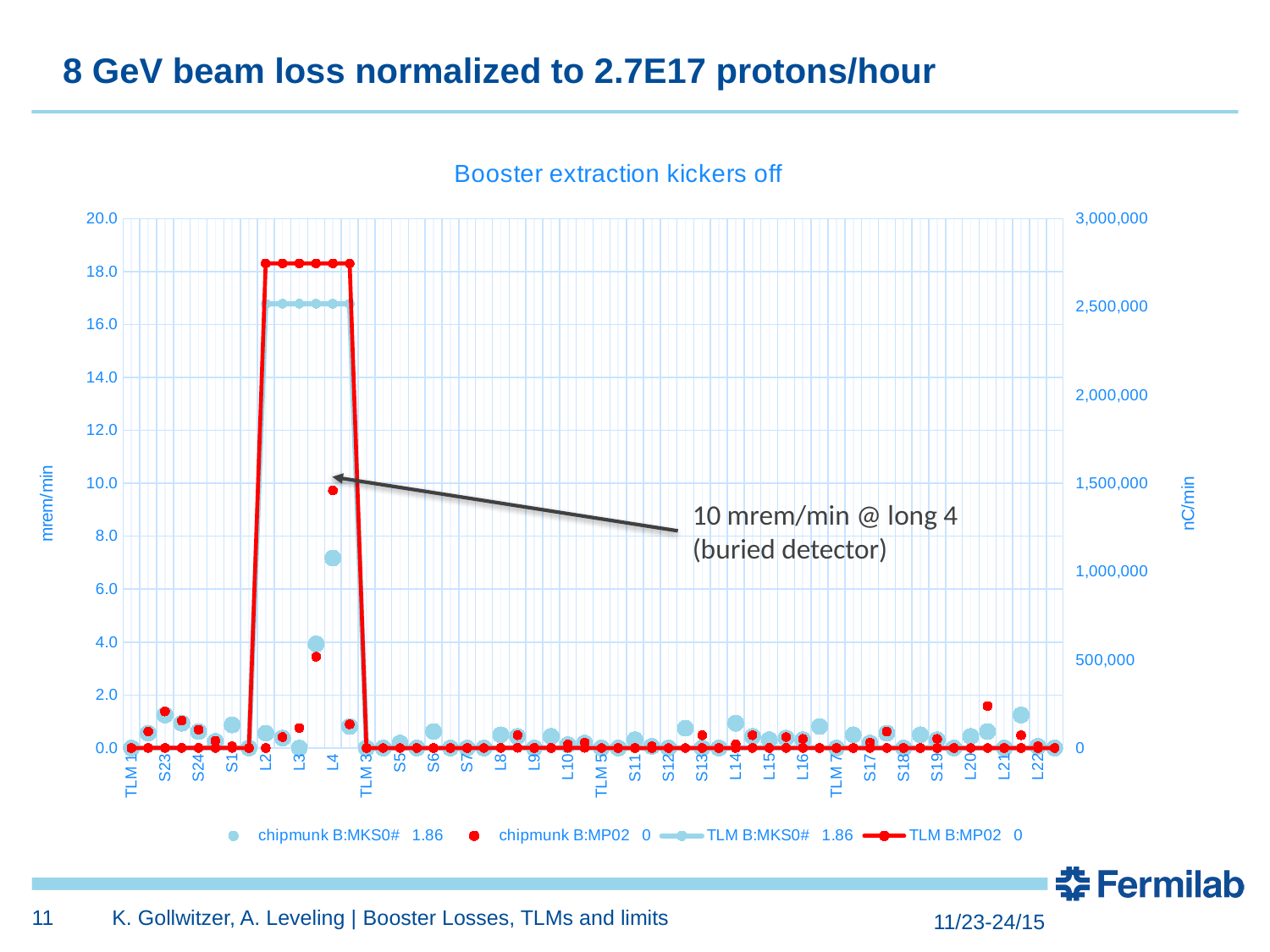
What kind of chart is shown on the slide? line chart Is the chipmunk B:MKS0# value at L4 greater or less than 8.0 mrem/min? less What does the annotation with the arrow on the chart say? 10 mrem/min @ long 4 (buried detector) Is the TLM B:MP02 value at L3 greater or less than 2,500,000 nC/min? greater Is the chipmunk B:MKS0# value at L4 greater or less than 6.0 mrem/min? greater How many series does the chart legend list? 4 What is the title of the chart? Booster extraction kickers off At which location does the chipmunk B:MP02 series reach its highest value? L4 At L4, which is larger: the chipmunk B:MP02 value or the chipmunk B:MKS0# value? chipmunk B:MP02